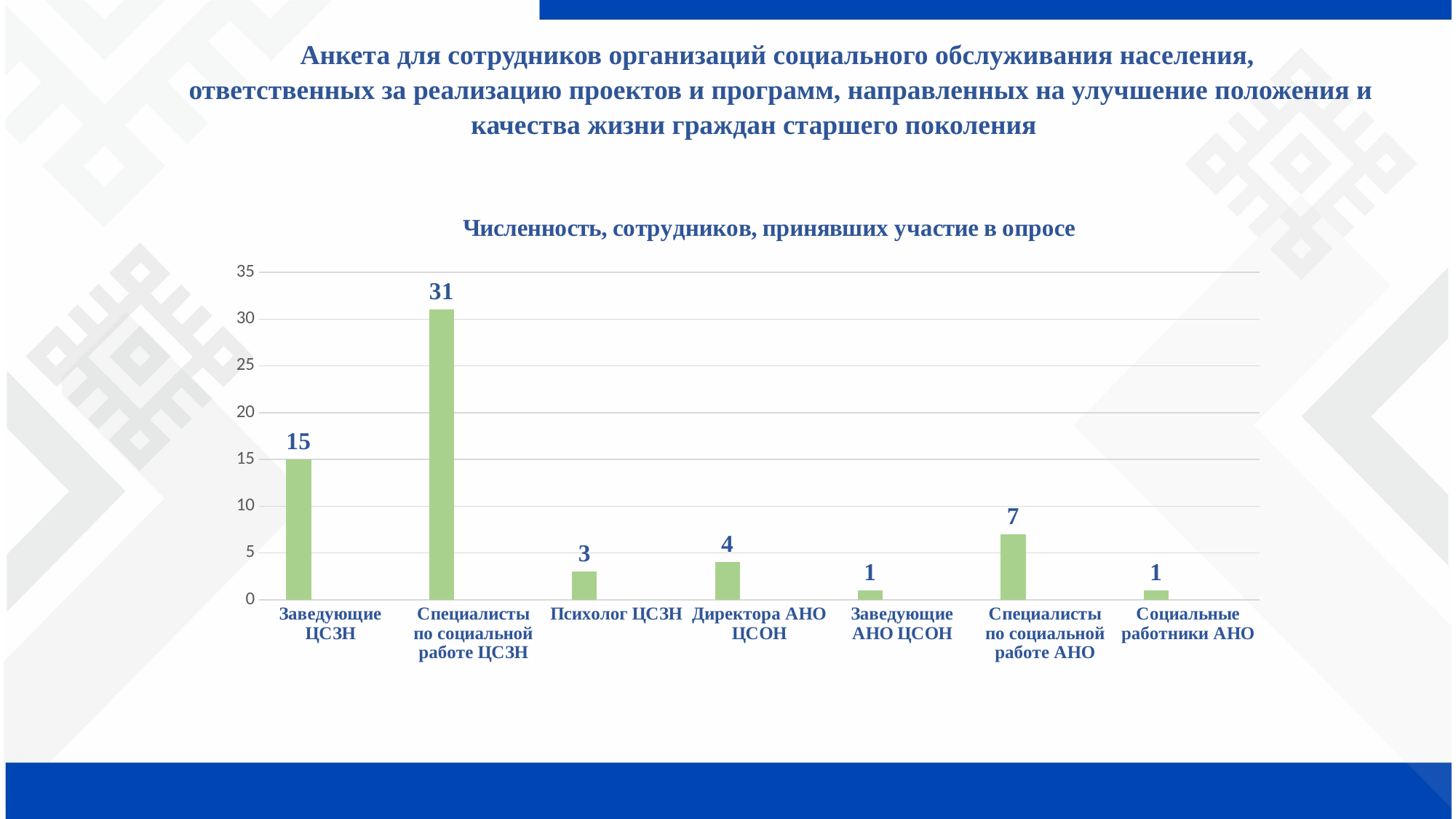
What kind of chart is shown on the slide? bar chart Which is larger: the value for Психолог ЦСЗН or the value for Директора АНО ЦСОН? Директора АНО ЦСОН What is the value for Директора АНО ЦСОН? 4 How many categories are shown on the x axis? 7 Which category has the highest value? Специалисты по социальной работе ЦСЗН What is the title of the chart? Численность, сотрудников, принявших участие в опросе What is the value for Заведующие ЦСЗН? 15 What is the difference between the values for Специалисты по социальной работе АНО and Социальные работники АНО? 6 Is the value for Специалисты по социальной работе ЦСЗН greater or less than 30? greater What is the value for Специалисты по социальной работе АНО? 7 What is the value for Специалисты по социальной работе ЦСЗН? 31 What is the difference between the values for Специалисты по социальной работе ЦСЗН and Заведующие ЦСЗН? 16